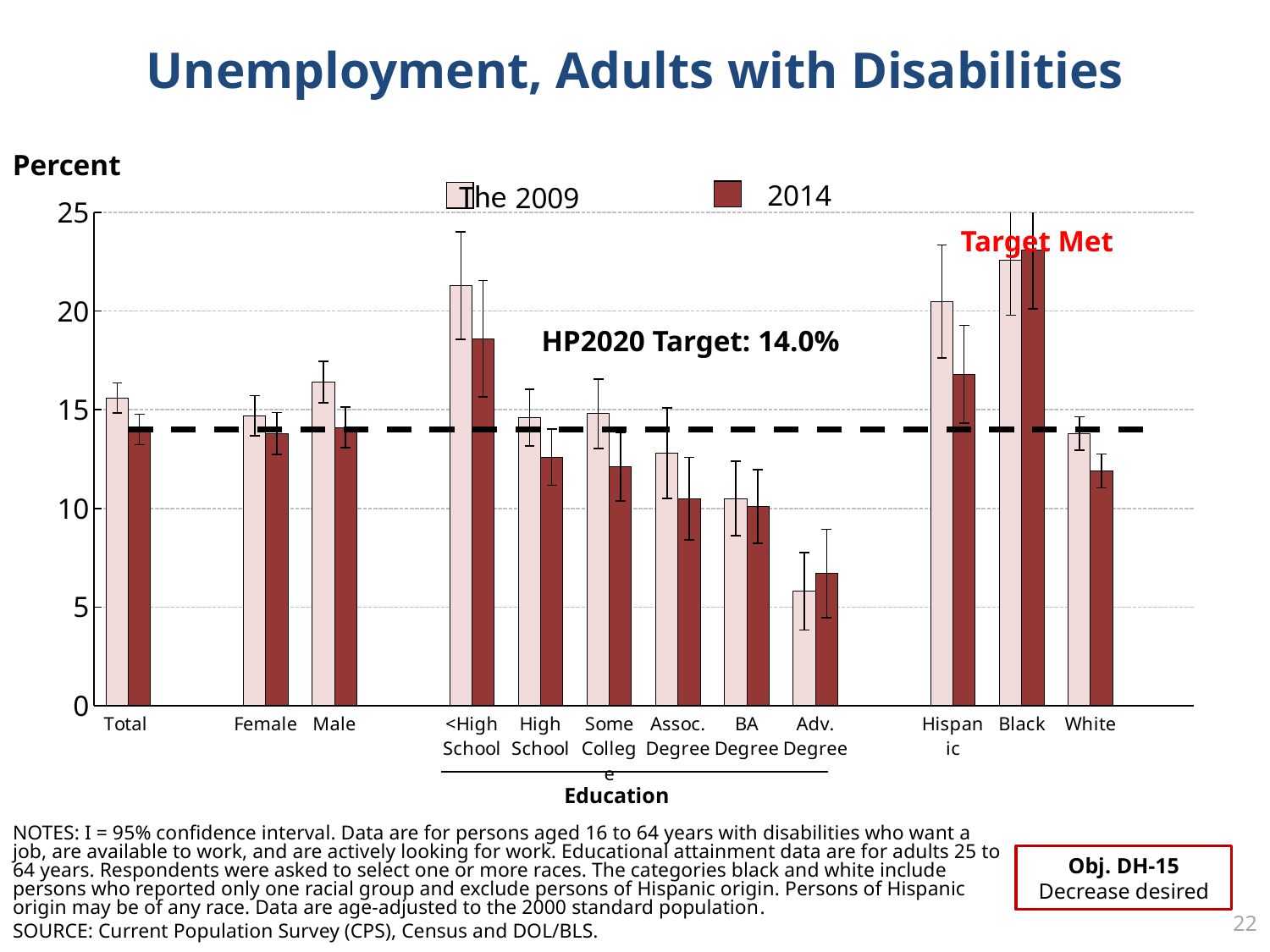
Is the 2009 value for <High School greater or less than 20? greater Which is larger, the 2014 value for Black or the 2014 value for White? Black What is the label on the y axis of the chart? Percent Is the 2009 value for Adv. Degree greater or less than 10? less How many series does the legend list? 2 Is the 2014 value for White greater or less than 15? less How many categories are shown along the x axis? 12 Which category has the highest 2014 value? Black What is the HP2020 target shown on the chart? 14.0% Which category has the lowest 2009 value? Adv. Degree What kind of chart is shown on the slide? Bar chart